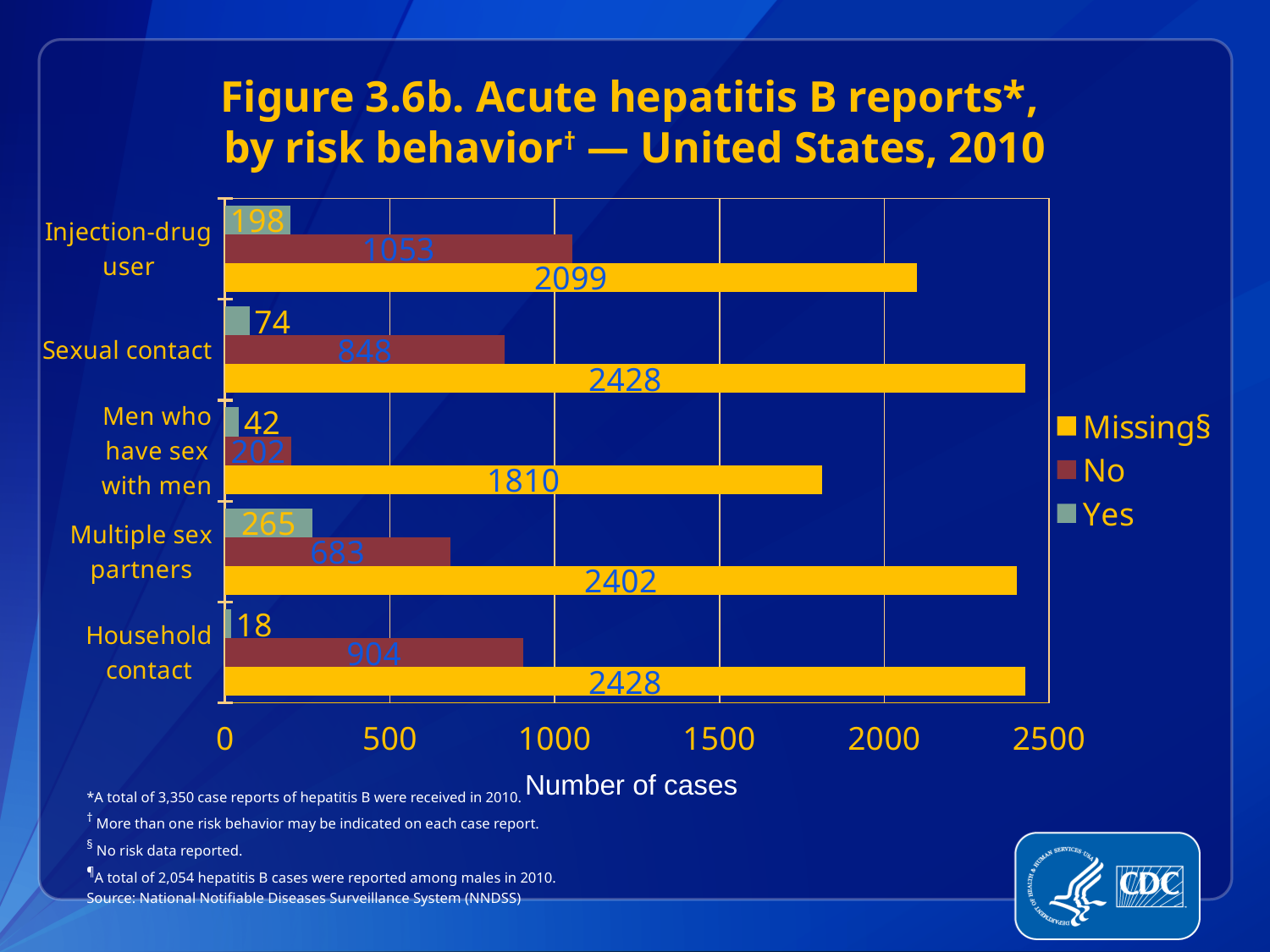
How many series does the legend list? 3 What is the label of the x axis? Number of cases Which is larger: the "No" value for Household contact or the "No" value for Multiple sex partners? Household contact What is the number of cases in the "Missing" series for Men who have sex with men? 1810 Which risk behavior has the lowest value in the "Missing" series? Men who have sex with men What is the number of cases in the "Yes" series for Injection-drug user? 198 Which risk behavior has the highest value in the "Yes" series? Multiple sex partners What is the number of cases in the "No" series for Household contact? 904 Which risk behavior has the lowest value in the "Yes" series? Household contact What kind of chart is shown on the slide? Bar chart How many risk behavior categories are shown on the chart? 5 What is the difference between the "No" values for Injection-drug user and Sexual contact? 205